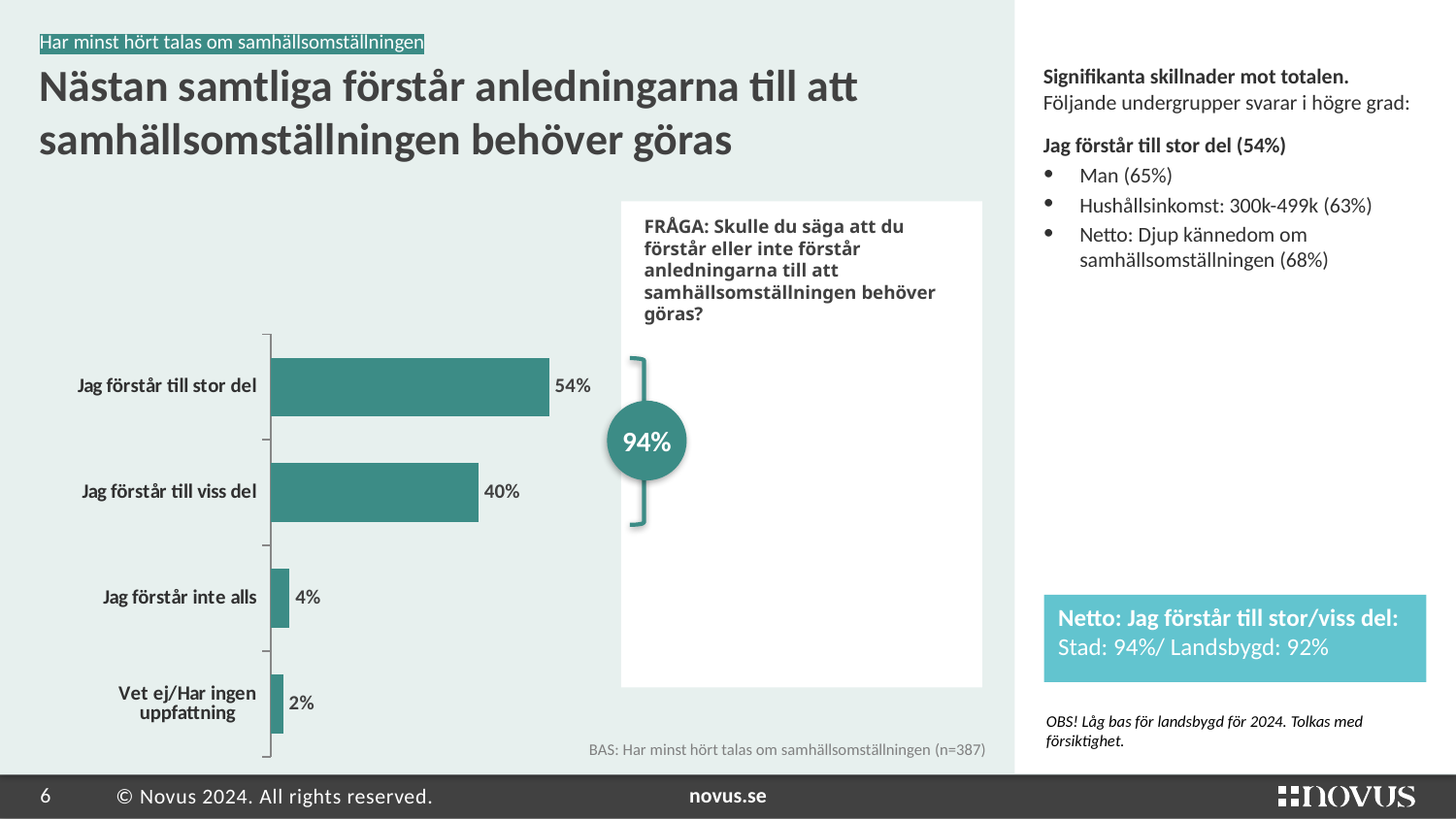
What is the combined value of "Jag förstår till stor del" and "Jag förstår till viss del" shown in the circle next to the chart? 94% What is the value for "Vet ej/Har ingen uppfattning"? 2% What is the value for "Jag förstår till viss del"? 40% What kind of chart is shown on the slide? Bar chart What is the value for "Jag förstår till stor del"? 54% What is the base (n) stated below the chart? n=387 Which category has the highest value? Jag förstår till stor del What is the value for "Jag förstår inte alls"? 4% What is the difference between "Jag förstår till stor del" and "Jag förstår till viss del"? 14 percentage points Which category has the lowest value? Vet ej/Har ingen uppfattning How many categories are shown in the chart? 4 Which is larger, "Jag förstår inte alls" or "Vet ej/Har ingen uppfattning"? Jag förstår inte alls